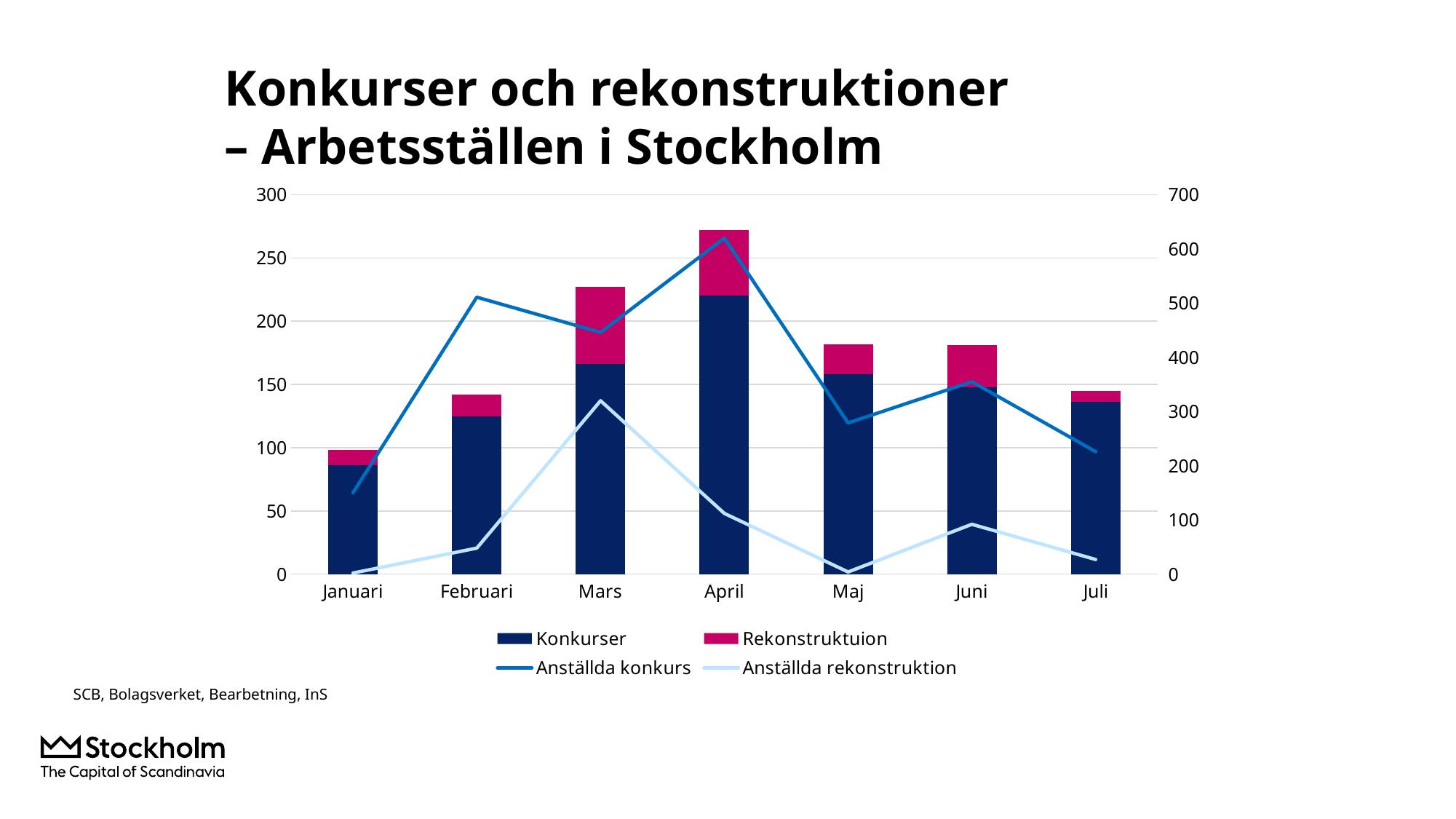
Which is larger, the Konkurser value for Februari or for Mars? Mars Does the Anställda konkurs line rise or fall from April to Maj? It falls Is the Konkurser value for Januari greater or less than 100? less How many series does the legend list? 4 Which month has the shortest stacked bar? Januari What kind of chart is shown on the slide? A combined bar and line chart Which month has the tallest stacked bar? April In which month does the Anställda rekonstruktion line reach its highest point? Mars How many months are shown on the x axis? 7 Is the Konkurser value for April greater or less than 200? greater Is the Anställda konkurs value for April greater or less than 500 on the right axis? greater